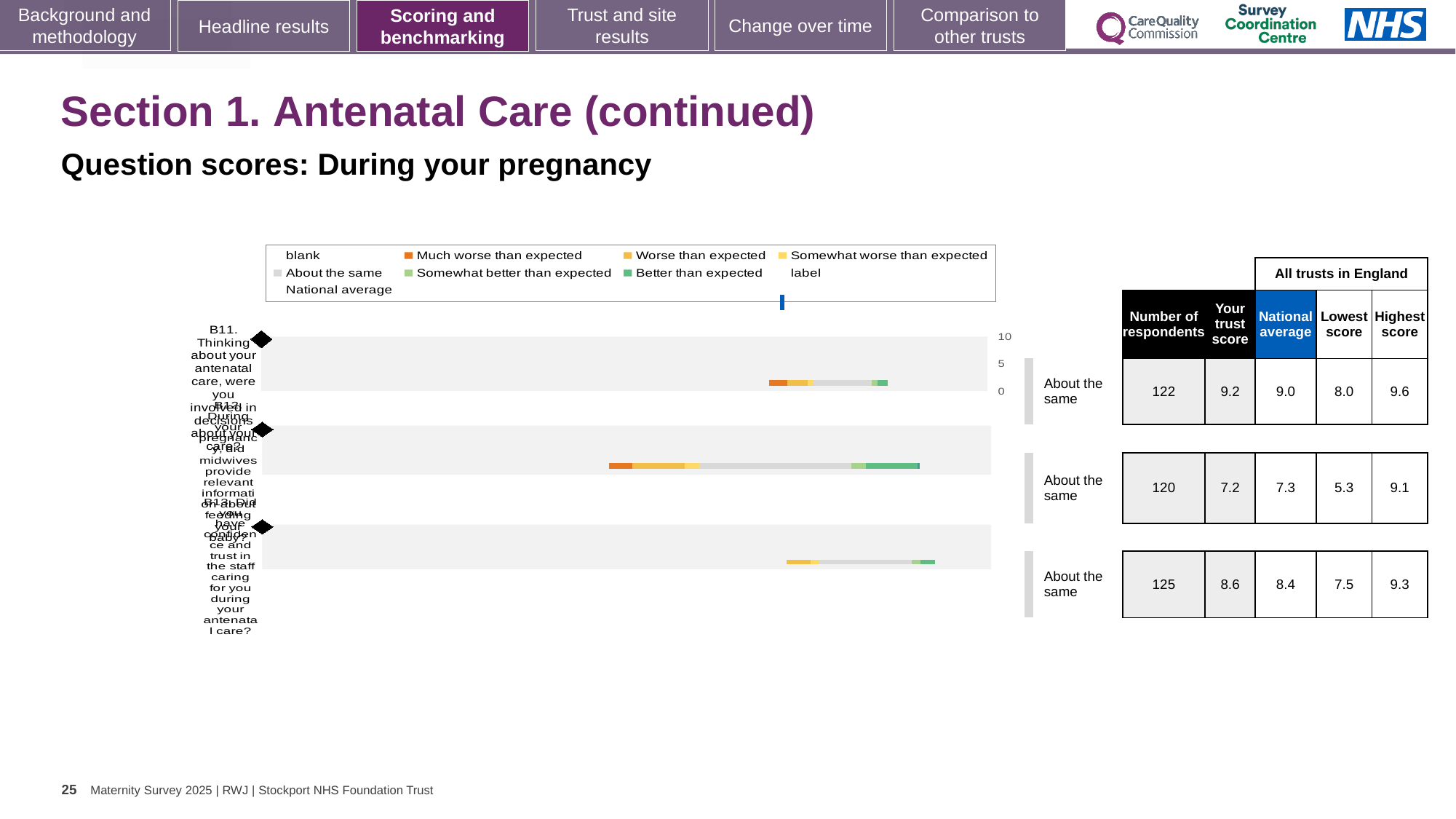
How many question rows (bars) are plotted in the chart? 3 For the bottom row (B13), which is larger: 'Your trust score' or the national average? Your trust score (8.6) Which question row has the lowest 'Your trust score'? B12 (middle row) What is the number of respondents for the middle row (B12)? 120 For the top row (B11), what is the difference between 'Your trust score' and the national average? 0.2 What is the 'Your trust score' for the top row (B11)? 9.2 What is the lowest score among all trusts in England for the middle row (B12)? 5.3 What is the highest score among all trusts in England for the bottom row (B13)? 9.3 Which question row has the highest 'Your trust score'? B11 (top row) What benchmark category is shown for all three question rows? About the same What colour represents 'Much worse than expected' in the legend? Orange What kind of chart is shown on the slide? Bar chart